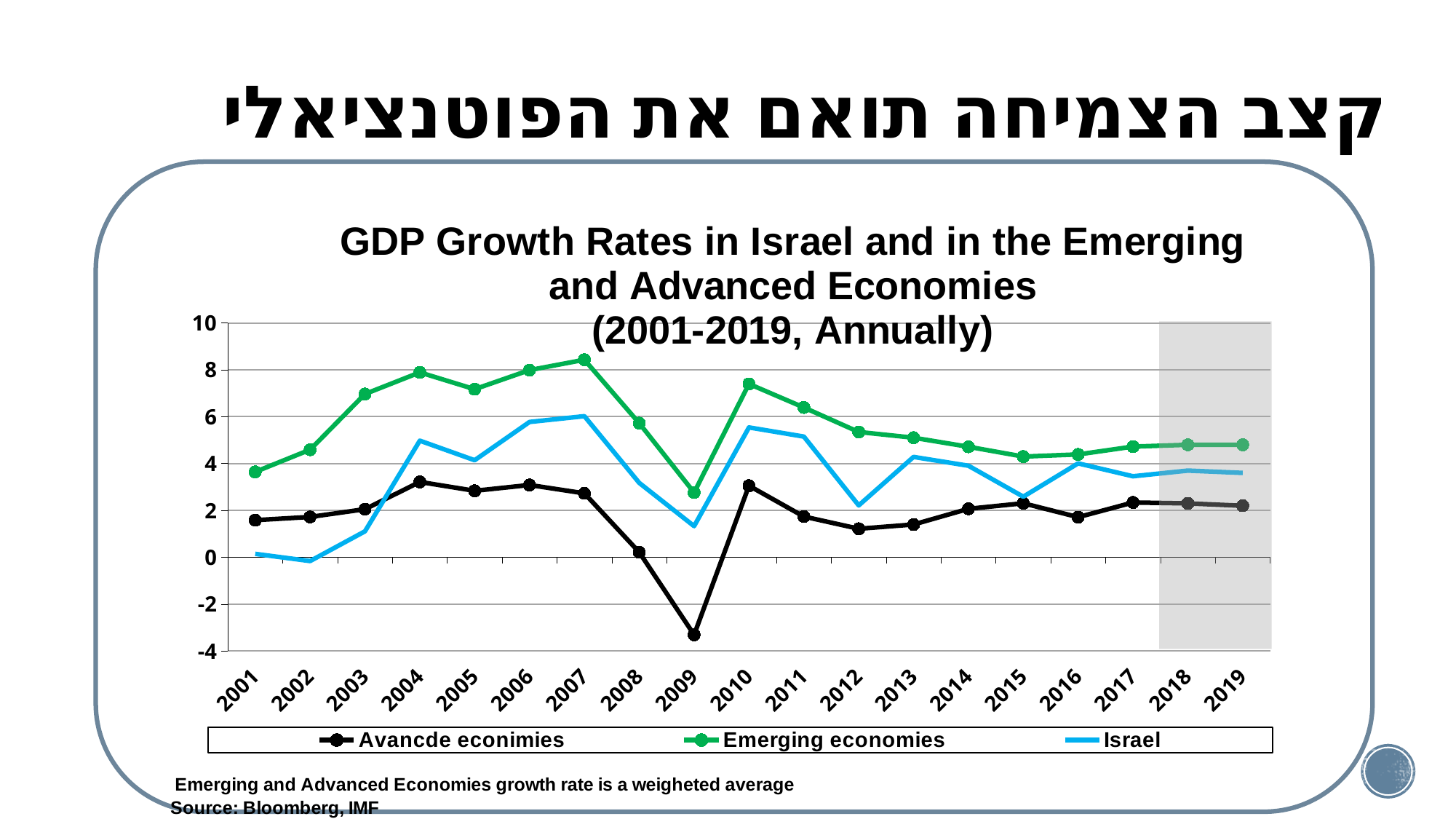
Is the value for Emerging economies in 2007 greater or less than 8? greater Does the Emerging economies series rise or fall from 2010 to 2015? fall How many series does the legend list? 3 Is the value for Avancde econimies in 2004 greater or less than 2? greater How many years are plotted along the x axis? 19 What kind of chart is shown on the slide? line chart In which year does the Emerging economies series reach its highest value? 2007 Which series is drawn in green? Emerging economies In 2009, which is larger: the value for Emerging economies or the value for Avancde econimies? Emerging economies Is the value for Avancde econimies in 2009 greater or less than -2? less In which year does the Avancde econimies series reach its lowest value? 2009